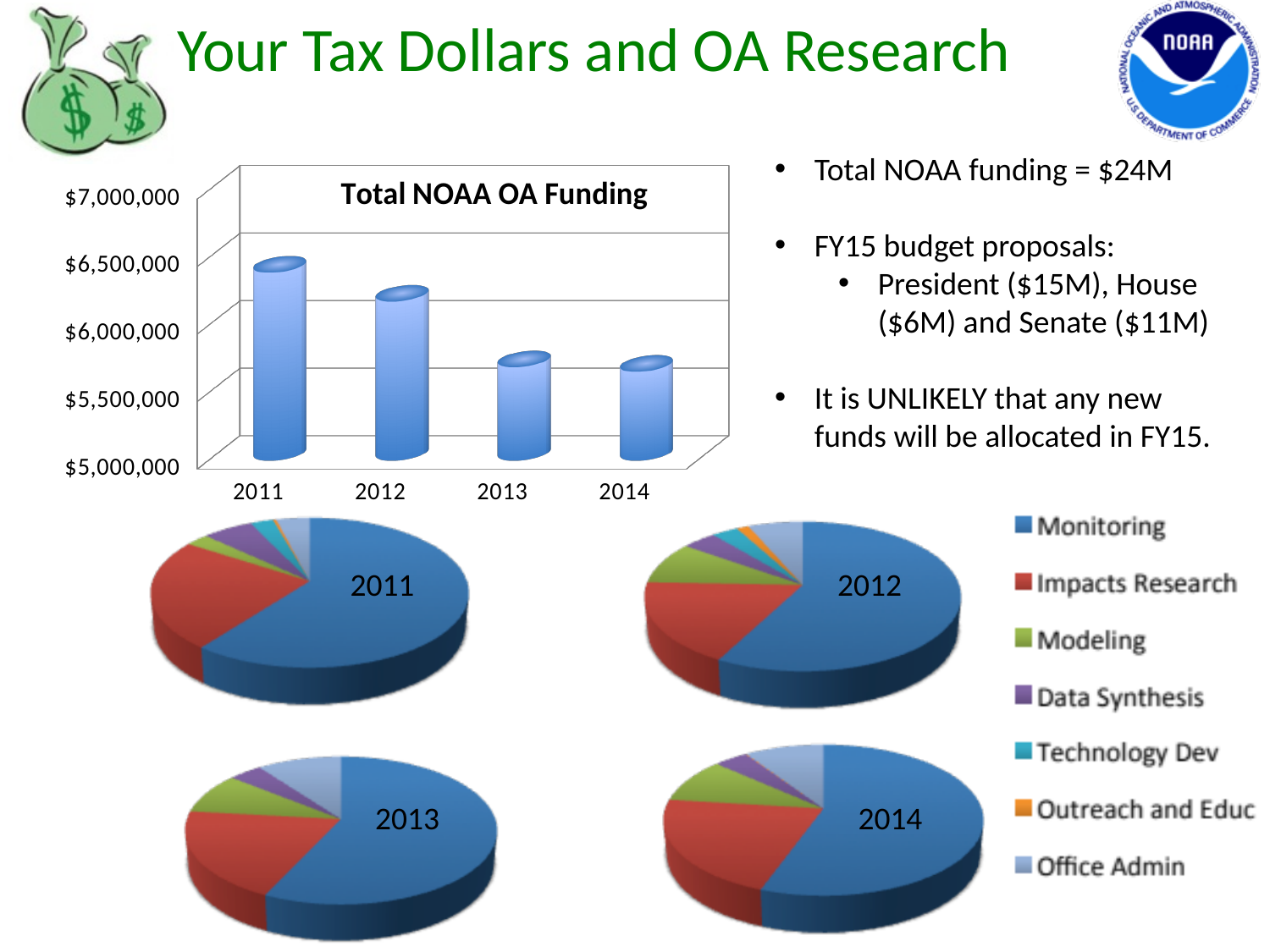
In the 'Total NOAA OA Funding' chart, is the value for 2011 greater or less than $6,000,000? greater What kind of chart is the 'Total NOAA OA Funding' chart? bar chart In the 'Total NOAA OA Funding' chart, which is larger, the value for 2011 or the value for 2013? 2011 How many years are shown on the x axis of the 'Total NOAA OA Funding' chart? 4 In the 'Total NOAA OA Funding' chart, which year has the highest funding? 2011 In the 2014 pie chart, which category has the second largest slice? Impacts Research How many categories does the legend for the pie charts list? 7 In the 2011 pie chart, which category has the largest slice? Monitoring In the 'Total NOAA OA Funding' chart, is the value for 2013 greater or less than $6,000,000? less In the 'Total NOAA OA Funding' chart, is the value for 2013 greater or less than $5,500,000? greater In the 'Total NOAA OA Funding' chart, do the values rise or fall from 2011 to 2014? fall